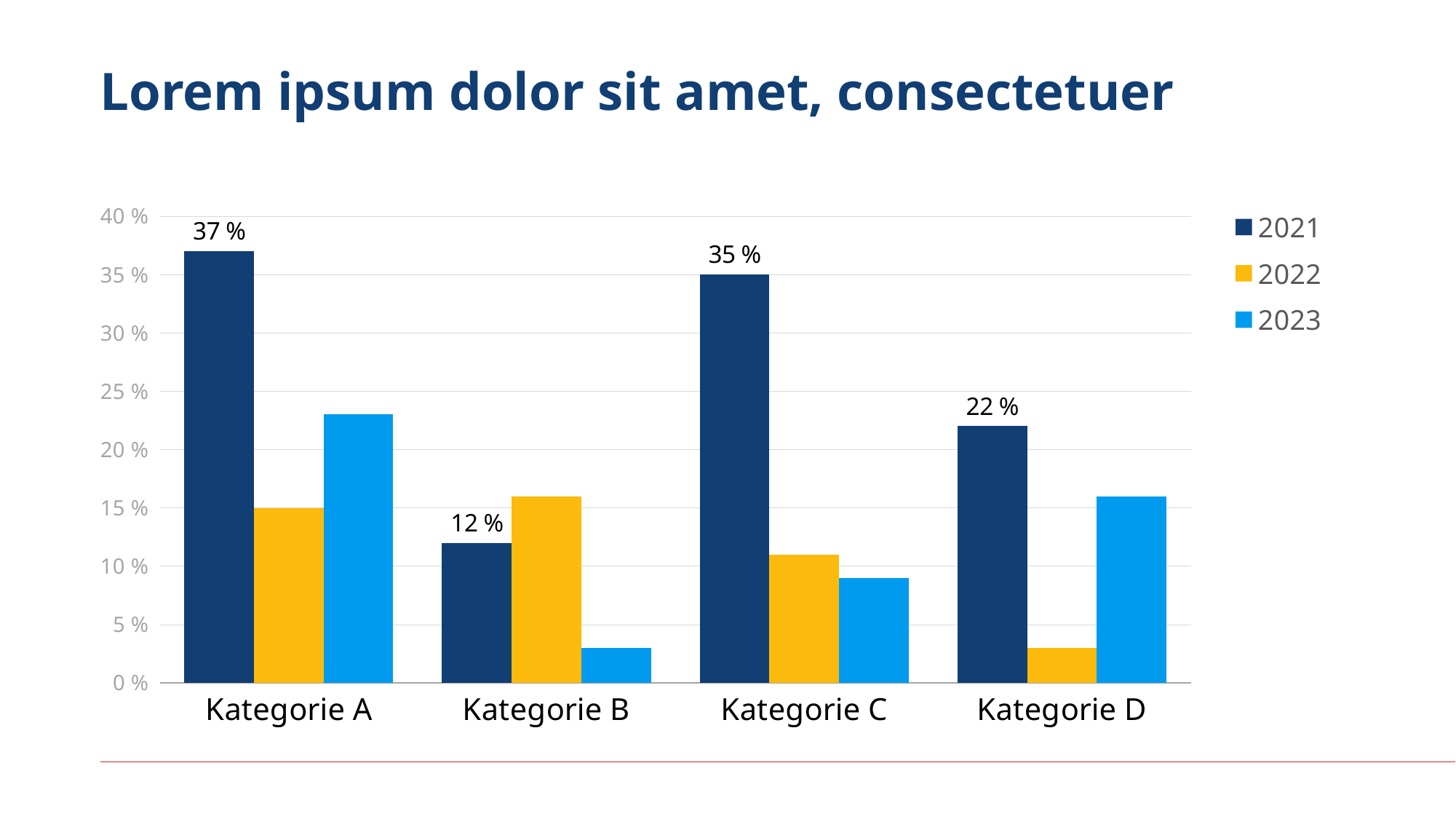
What is the value for 2021 in Kategorie B? 12 % Which is larger for 2021: Kategorie C or Kategorie D? Kategorie C What is the value for 2021 in Kategorie A? 37 % How many series does the legend list? 3 How many categories are shown on the x axis? 4 Which category has the lowest value for 2021? Kategorie B Is the value for 2023 in Kategorie A greater or less than 20 %? greater What is the value for 2021 in Kategorie D? 22 % Is the value for 2022 in Kategorie D greater or less than 5 %? less What is the difference between the 2021 values for Kategorie A and Kategorie B? 25 % Which category has the highest value for 2021? Kategorie A What is the value for 2021 in Kategorie C? 35 %